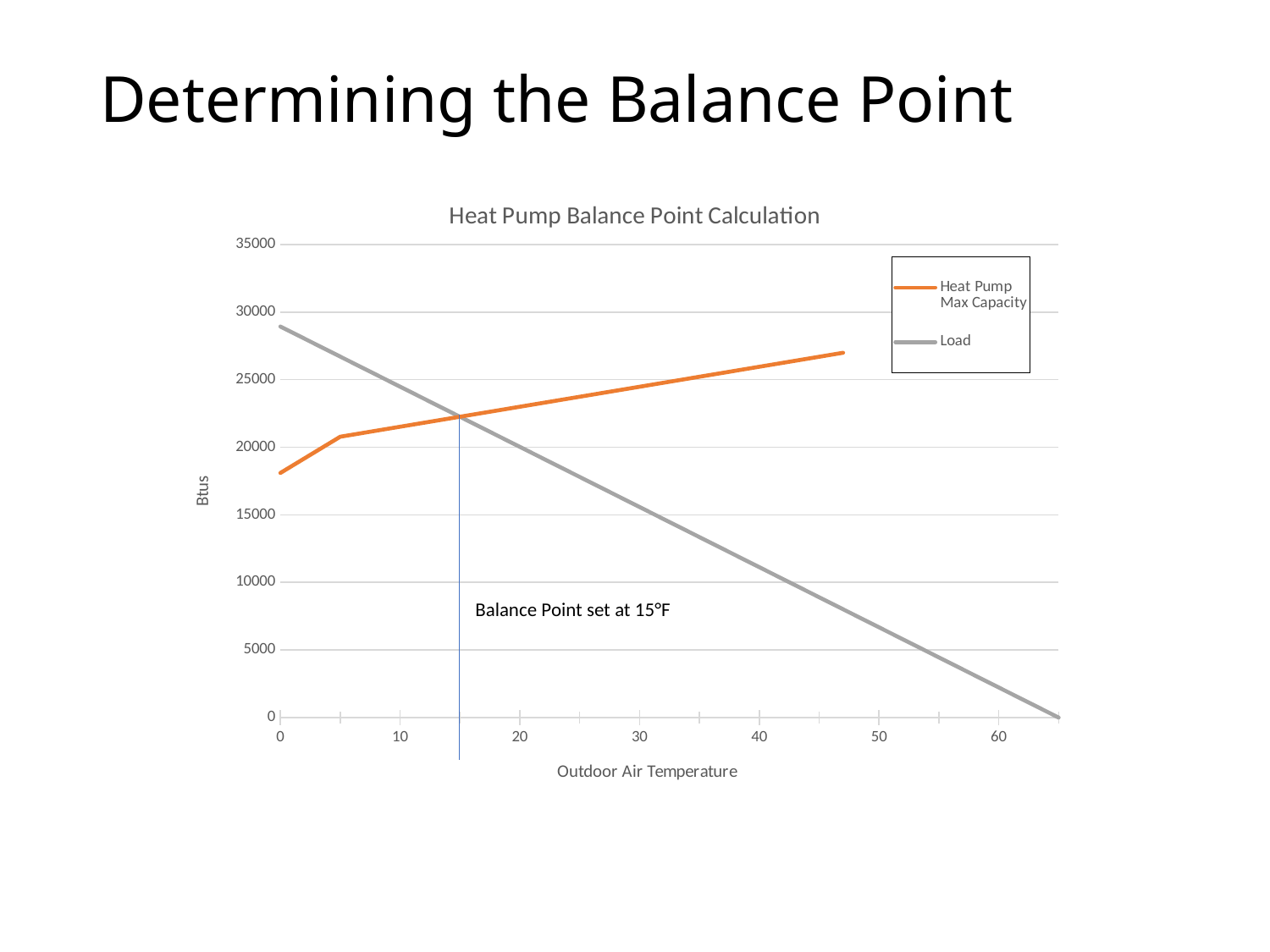
Does the Heat Pump Max Capacity series rise or fall as Outdoor Air Temperature increases? rise Is the Heat Pump Max Capacity value at an Outdoor Air Temperature of 0 greater or less than 20000? less What is the title of the chart? Heat Pump Balance Point Calculation Is the Load value at an Outdoor Air Temperature of 0 greater or less than 25000? greater At an Outdoor Air Temperature of 40, which series has the higher value, Heat Pump Max Capacity or Load? Heat Pump Max Capacity What kind of chart is shown on the slide? line chart How many series does the legend list? 2 At an Outdoor Air Temperature of 0, which series has the higher value, Heat Pump Max Capacity or Load? Load Is the Load value at an Outdoor Air Temperature of 60 greater or less than 5000? less At what Outdoor Air Temperature is the Balance Point set, according to the annotation on the chart? 15°F Does the Load series rise or fall as Outdoor Air Temperature increases? fall Which series is drawn in orange? Heat Pump Max Capacity